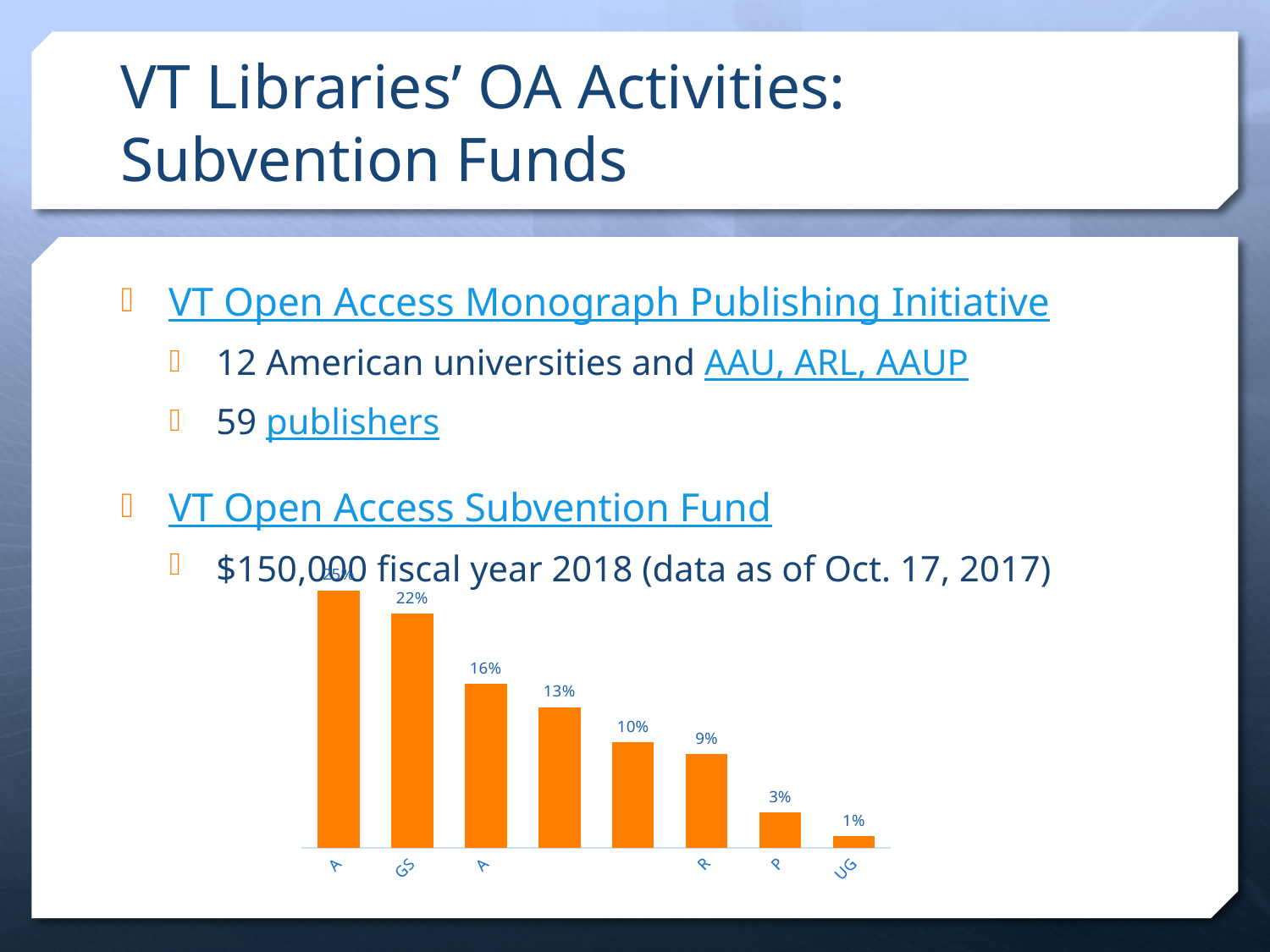
How many bars are plotted in the chart? 8 What is the value shown for the bar labelled UG? 1% Which category has the lowest value in the chart? UG Do the bar values rise or fall from left to right across the chart? fall What is the value shown for the bar labelled R? 9% What is the difference between the values for GS and R? 13% What is the value shown for the bar labelled GS? 22% What colour are the bars in the chart? orange Which bar is the tallest in the chart? the leftmost bar What is the value shown for the bar labelled P? 3% What kind of chart is shown on the slide? bar chart Which is larger, the value for GS or the value for P? GS